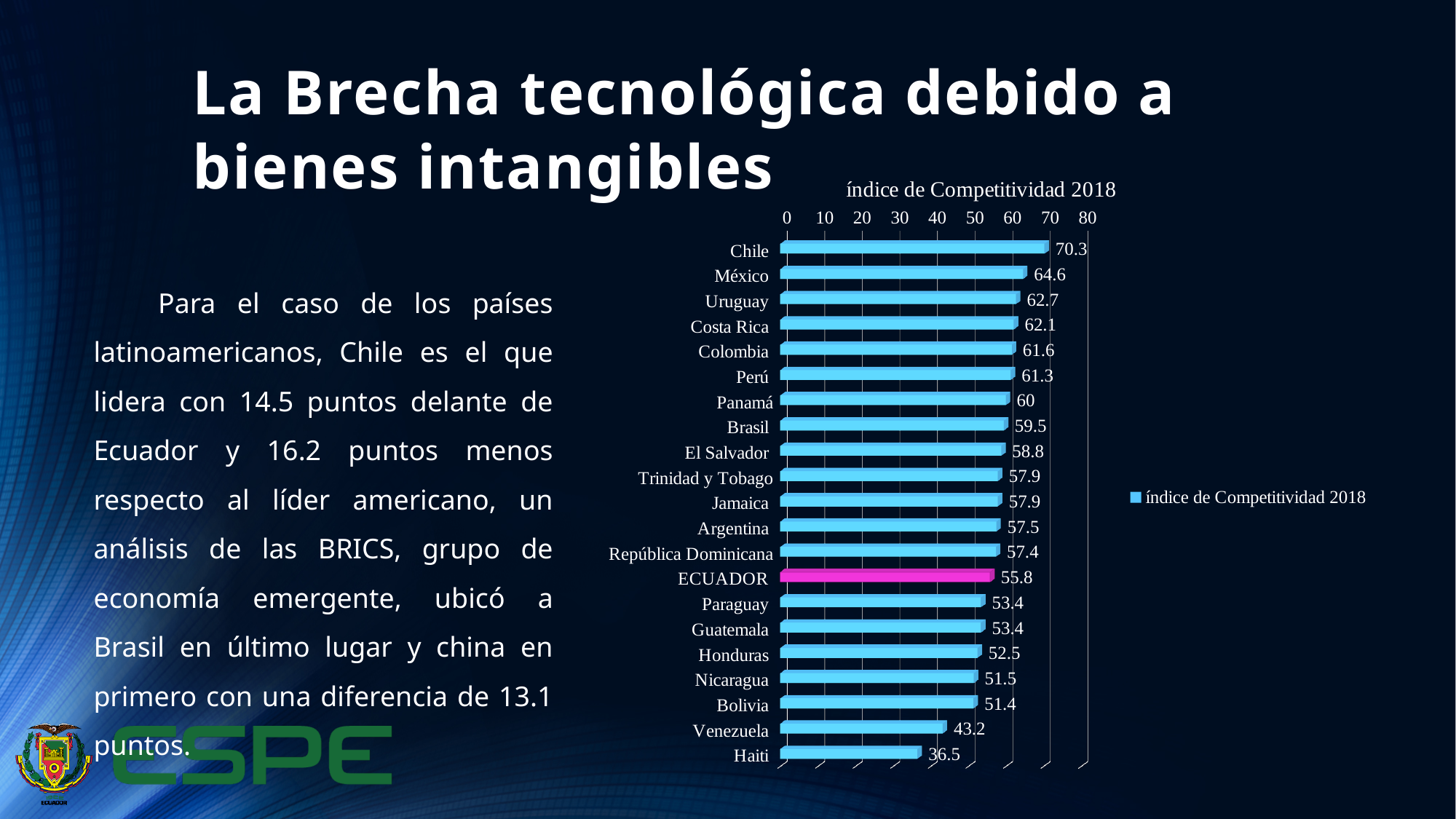
What is the title of the chart? índice de Competitividad 2018 What is the value shown for ECUADOR? 55.8 What is the índice de Competitividad 2018 value for Chile? 70.3 What is the difference between Chile's value and Haiti's value? 33.8 What kind of chart is shown on the slide? Bar chart Which country has the lowest índice de Competitividad 2018? Haiti Which country has the highest índice de Competitividad 2018? Chile How many countries are shown in the chart? 21 Which has a higher value, México or Uruguay? México Is the value for Haiti greater or less than 40? less What is the difference between Chile's value and ECUADOR's value? 14.5 What is the value shown for Venezuela? 43.2